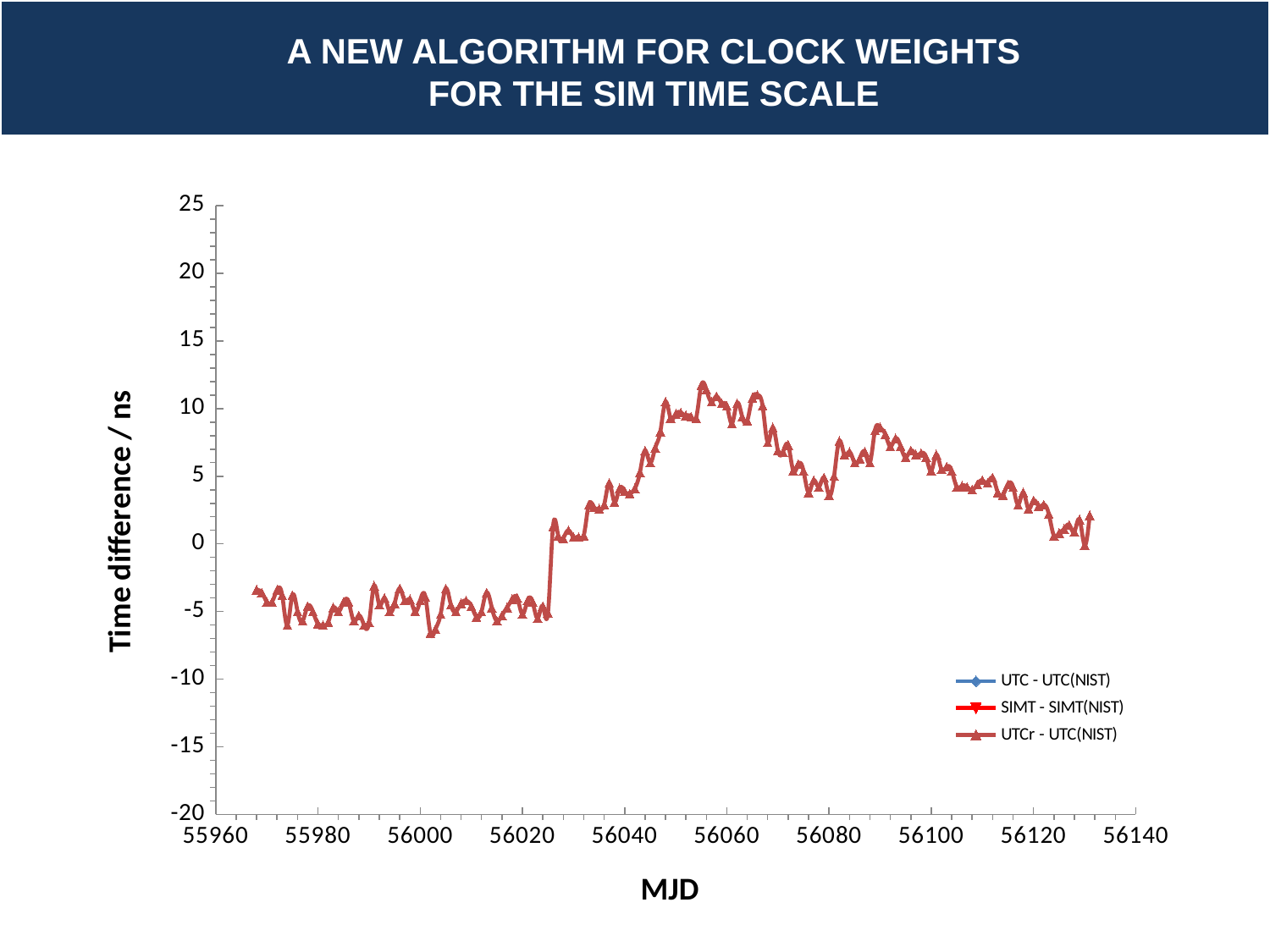
What kind of chart is shown on the slide? line chart What is the label of the x axis? MJD Is the value of the plotted line at MJD 55980 greater or less than -10? greater Is the value of the plotted line at MJD 56040 greater or less than 0? greater Between MJD 56065 and MJD 56125, do the plotted values generally rise or fall? fall Between MJD 56025 and MJD 56055, do the plotted values generally rise or fall? rise Is the value of the plotted line at MJD 56000 greater or less than 0? less How many series does the legend list? 3 What is the label of the y axis? Time difference / ns Which is larger, the plotted value at MJD 56055 or the plotted value at MJD 56010? MJD 56055